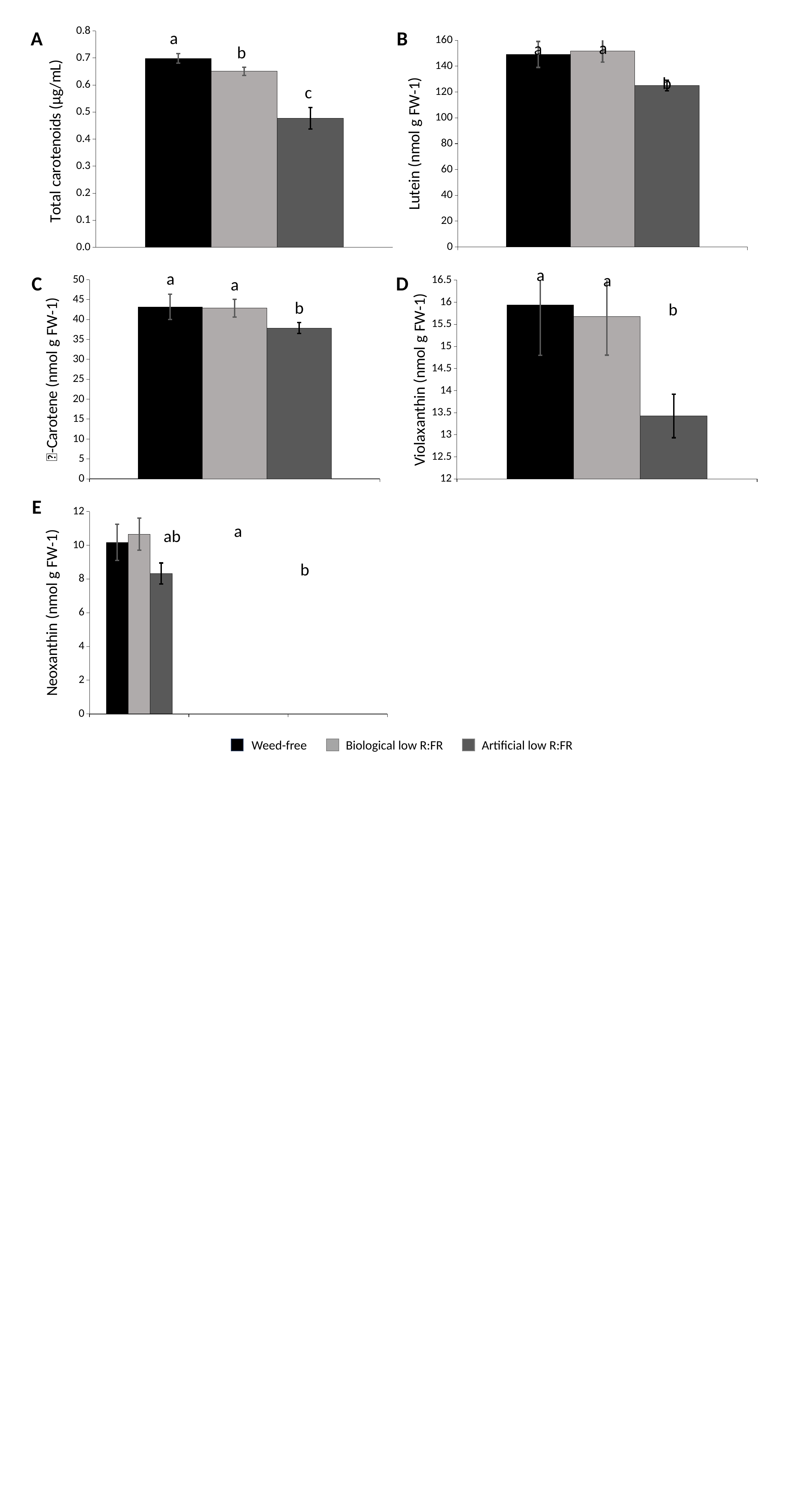
How many series does the legend list? 3 In chart D (Violaxanthin), is the value for Artificial low R:FR greater or less than 14? less In chart B (Lutein), is the value for Artificial low R:FR greater or less than 140? less In chart A (Total carotenoids), is the value for Weed-free greater or less than 0.6? greater How many bars are plotted in chart E (Neoxanthin)? 3 What kind of chart is chart A (Total carotenoids)? bar chart In chart E (Neoxanthin), which treatment has the lowest value? Artificial low R:FR In chart C (β-Carotene), is the value for Weed-free larger or smaller than the value for Artificial low R:FR? larger In chart B (Lutein), which treatment has the lowest value? Artificial low R:FR In chart A (Total carotenoids), which treatment has the highest value? Weed-free In chart A (Total carotenoids), which treatment has the lowest value? Artificial low R:FR